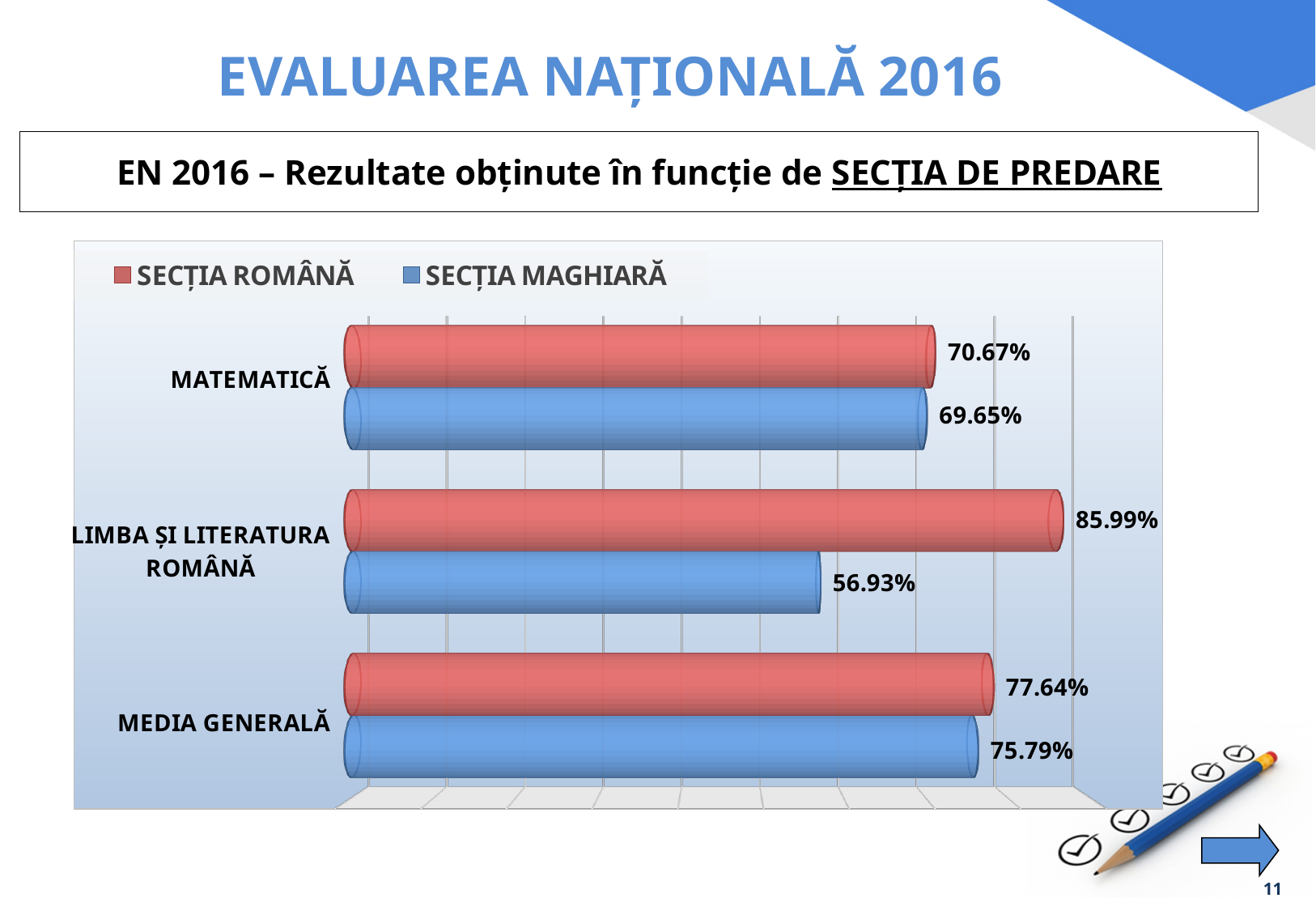
What is the value for SECȚIA MAGHIARĂ in LIMBA ȘI LITERATURA ROMÂNĂ? 56.93% Which is larger in LIMBA ȘI LITERATURA ROMÂNĂ: SECȚIA ROMÂNĂ or SECȚIA MAGHIARĂ? SECȚIA ROMÂNĂ What is the difference between SECȚIA ROMÂNĂ and SECȚIA MAGHIARĂ in LIMBA ȘI LITERATURA ROMÂNĂ? 29.06% How many series does the legend list? 2 How many categories are shown on the chart? 3 What is the value for SECȚIA MAGHIARĂ in MEDIA GENERALĂ? 75.79% What is the difference between SECȚIA ROMÂNĂ and SECȚIA MAGHIARĂ in MATEMATICĂ? 1.02% Which category has the highest value for SECȚIA ROMÂNĂ? LIMBA ȘI LITERATURA ROMÂNĂ What is the value for SECȚIA ROMÂNĂ in MATEMATICĂ? 70.67% Which category has the lowest value for SECȚIA MAGHIARĂ? LIMBA ȘI LITERATURA ROMÂNĂ What is the value for SECȚIA ROMÂNĂ in MEDIA GENERALĂ? 77.64% What kind of chart is shown on the slide? Bar chart